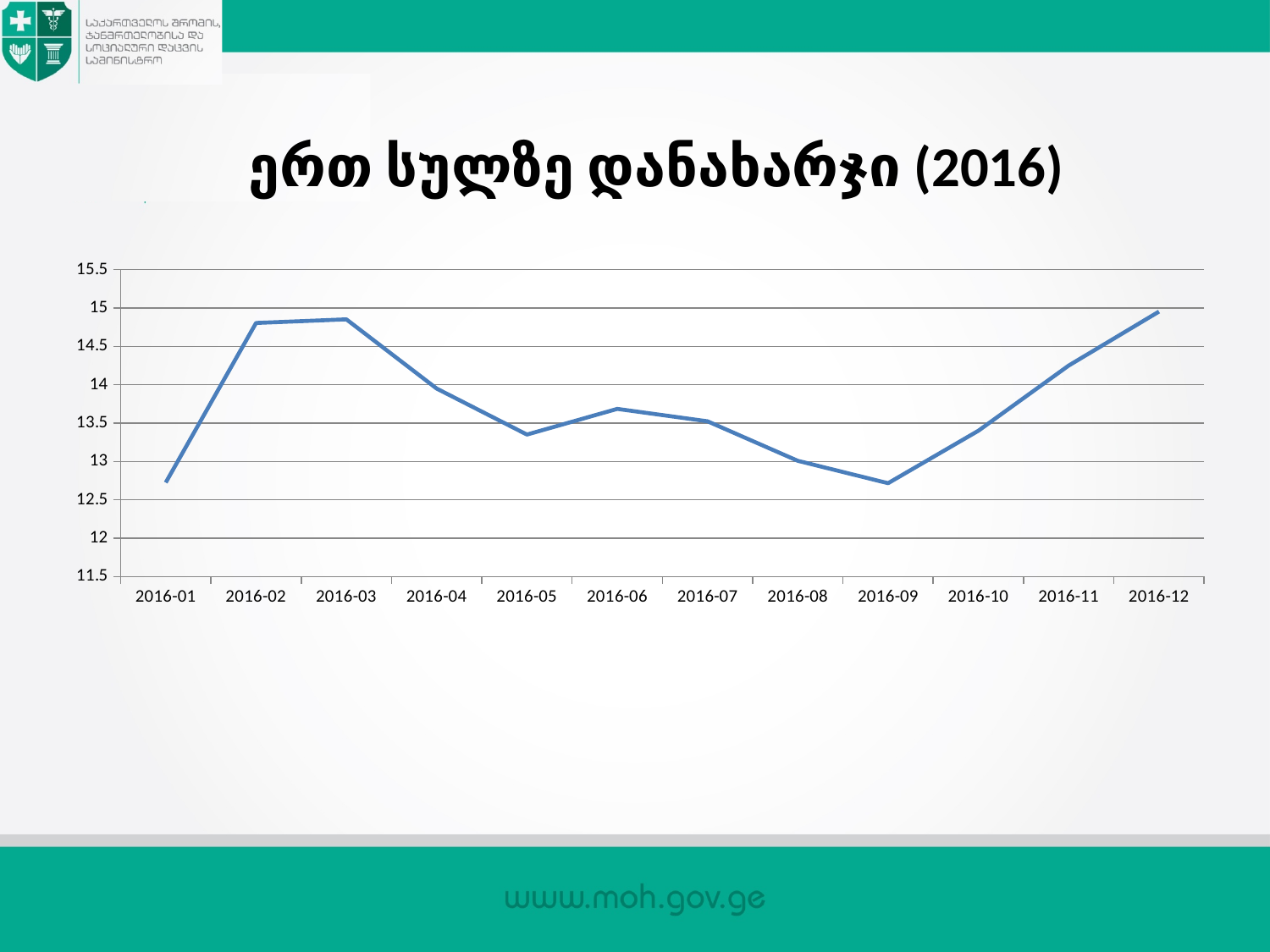
Is the value for 2016-01 greater or less than 13? less How many months are plotted on the x axis? 12 Is the value for 2016-11 greater or less than 14? greater Is the value for 2016-09 greater or less than 13? less What kind of chart is shown on the slide? line chart Do the values rise or fall from 2016-09 to 2016-12? rise Which is larger, the value for 2016-08 or the value for 2016-11? 2016-11 What is the title of the chart? ერთ სულზე დანახარჯი (2016) Which is larger, the value for 2016-02 or the value for 2016-05? 2016-02